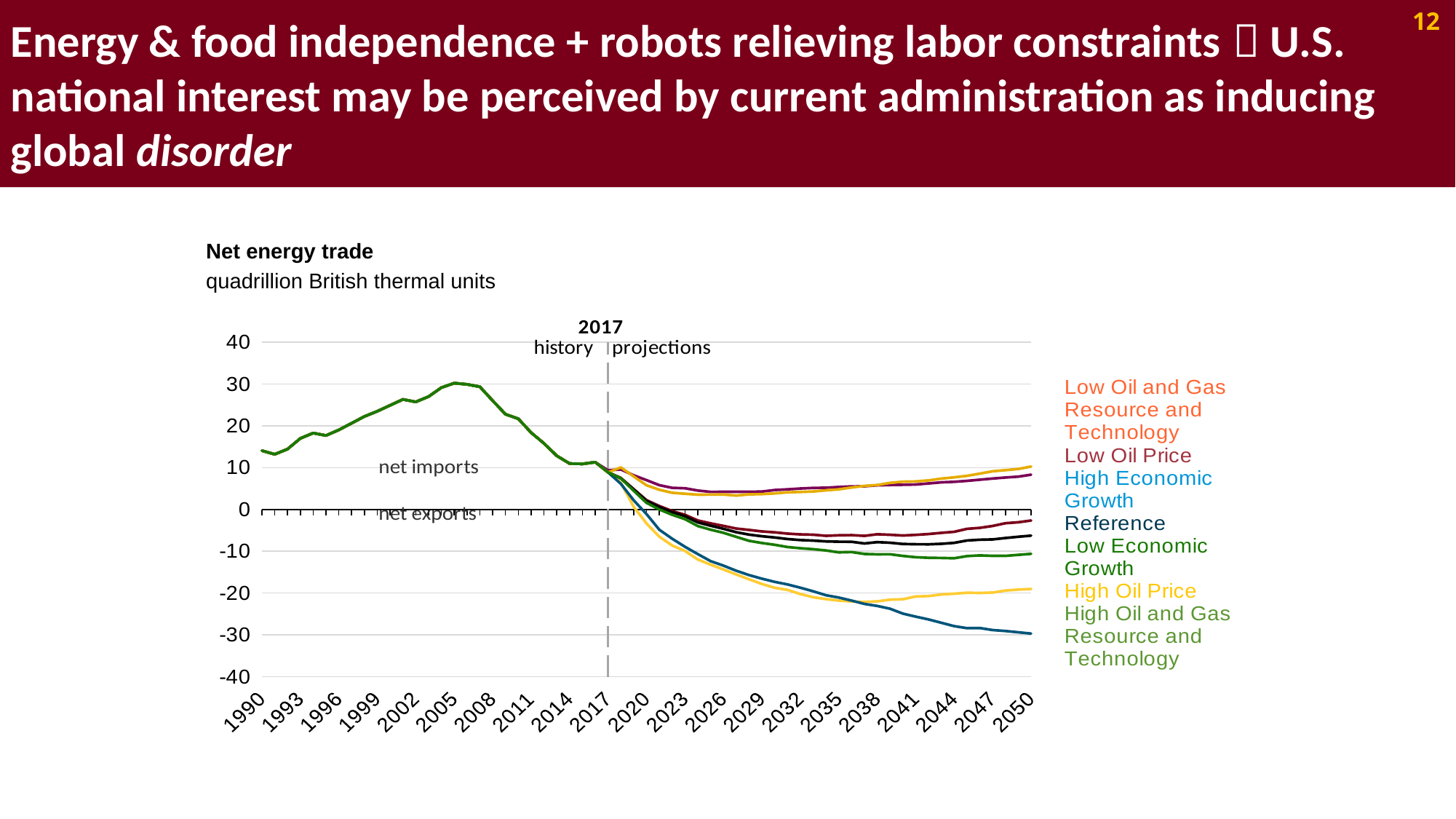
Is the value of net energy trade in 2014 greater or less than 20? less What is the title of the chart? Net energy trade What kind of chart is shown on the slide? line chart Do the values of the historical line rise or fall between 2008 and 2017? fall Is the lowest projected line in 2050 greater or less than -20? less How many year labels are shown on the x axis? 21 How many series does the legend list? 7 In what units are the values on the chart measured? quadrillion British thermal units Which year marks the boundary between history and projections on the chart? 2017 Do the values of the historical line rise or fall between 1990 and 2005? rise Is the value of net energy trade in 2005 greater or less than 20? greater